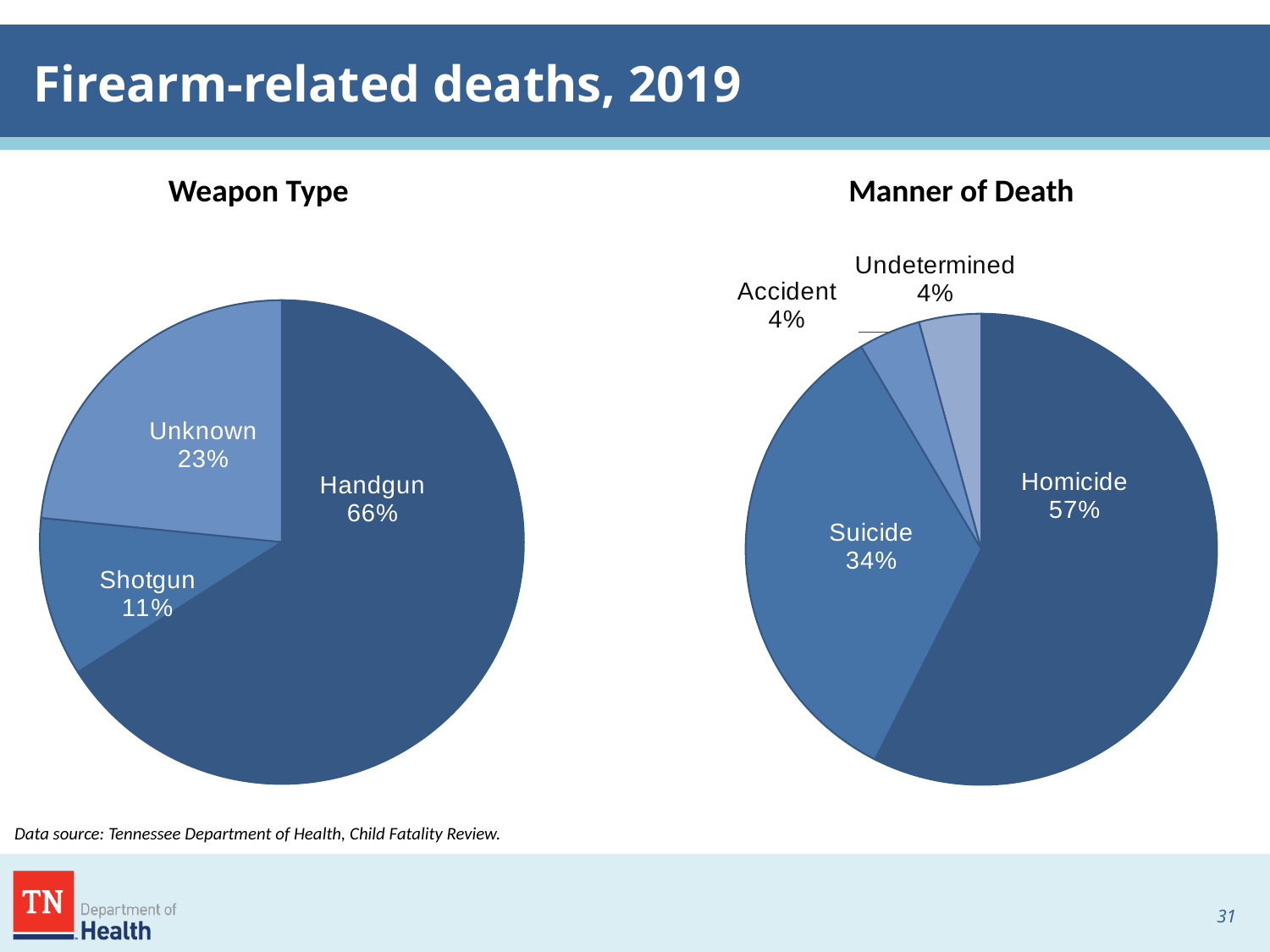
In the Weapon Type chart, which weapon type has the smallest share? Shotgun In the Weapon Type chart, what percentage is shown for Shotgun? 11% In the Manner of Death chart, what is the difference in percentage points between Homicide and Suicide? 23 In the Manner of Death chart, what percentage of deaths were homicides? 57% In the Weapon Type chart, how many slices does the pie have? 3 What type of chart is used for the Manner of Death chart? Pie chart In the Weapon Type chart, what percentage is shown for Unknown? 23% In the Weapon Type chart, what share of firearm-related deaths involved a handgun? 66% In the Weapon Type chart, which weapon type has the largest share? Handgun In the Manner of Death chart, which is larger, Accident or Suicide? Suicide In the Manner of Death chart, how many categories are shown? 4 In the Manner of Death chart, what percentage of deaths were suicides? 34%